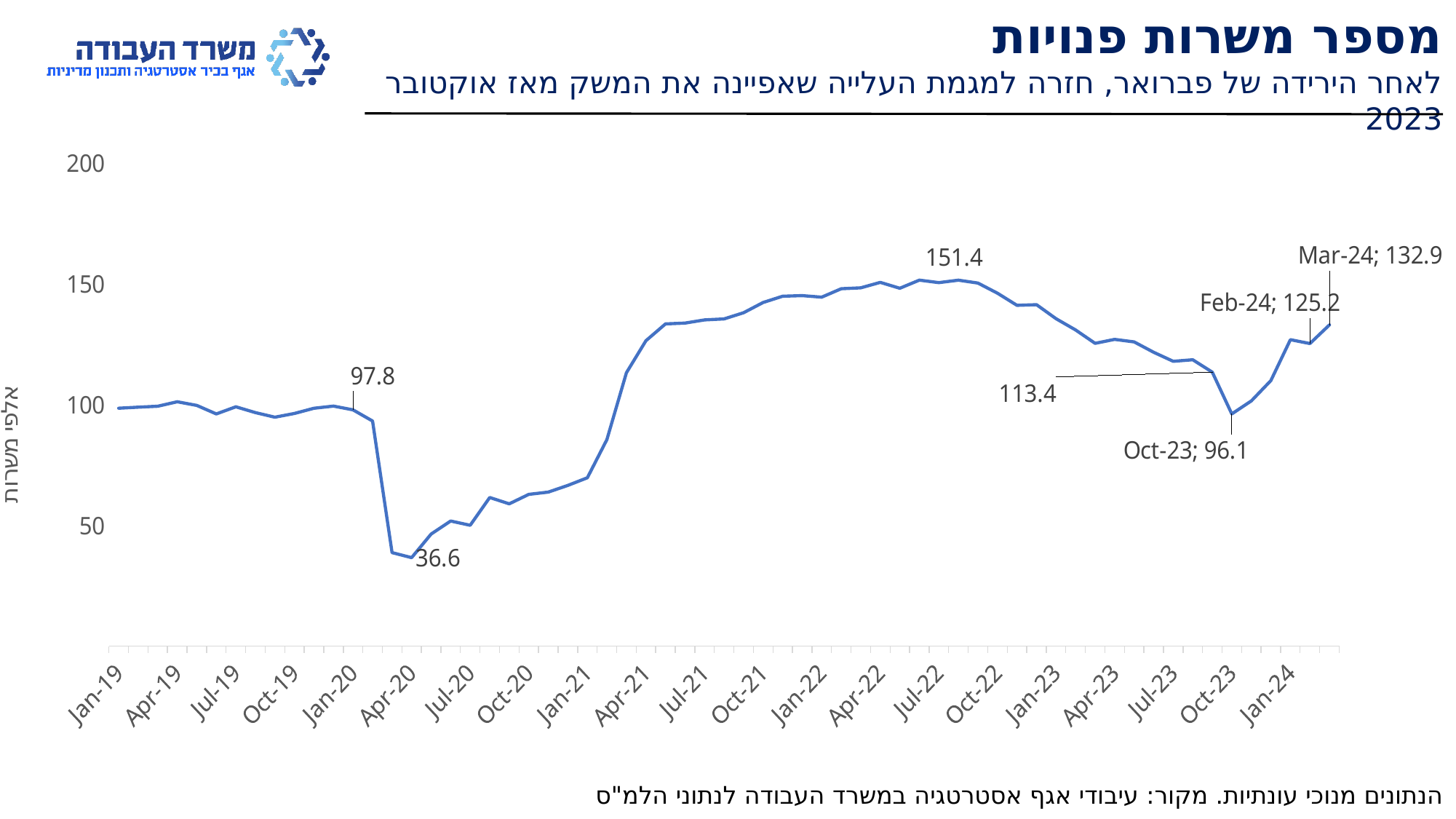
Does the line rise or fall between Oct-23 and Mar-24? rises What is the highest value labelled on the line? 151.4 What is the value labelled for Mar-24? 132.9 Is the value for Jan-19 greater or less than 150? less What type of chart is shown on the slide? line chart Which is larger, the value for Feb-24 or the value for Oct-23? Feb-24 What is the value labelled for Oct-23? 96.1 What is the value labelled for Feb-24? 125.2 What is the label on the vertical axis? אלפי משרות What is the difference between the highest labelled value (151.4) and the lowest labelled value (36.6)? 114.8 What is the difference between the Mar-24 value and the Feb-24 value? 7.7 What is the lowest value labelled on the line? 36.6